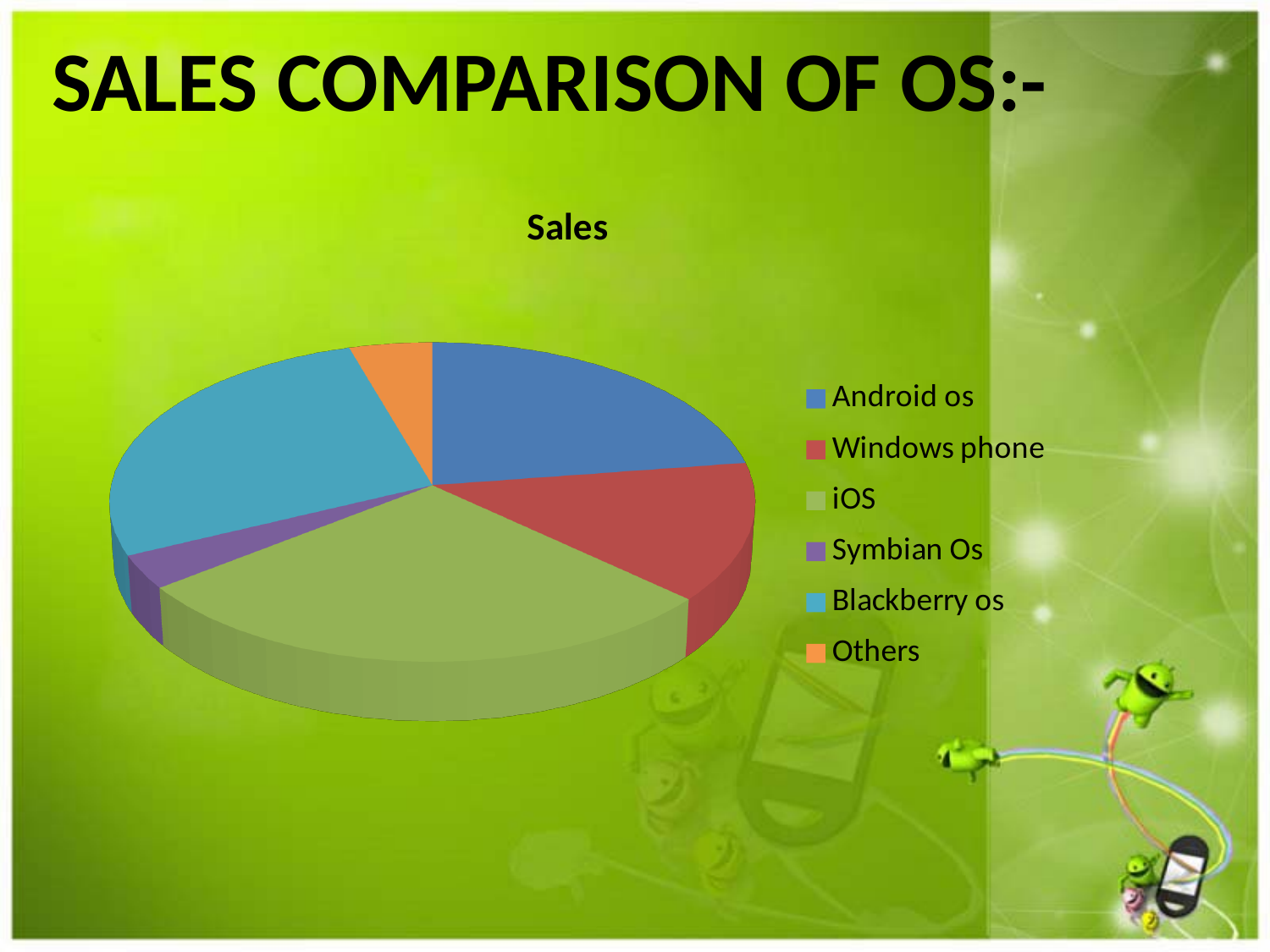
What is the title of the pie chart? Sales Which slice is larger, Blackberry os or Windows phone? Blackberry os How many entries does the legend of the pie chart list? 6 Which slice is larger, Android os or Windows phone? Android os Which slice is larger, Blackberry os or Symbian Os? Blackberry os How many categories (slices) does the pie chart have? 6 What kind of chart is shown on the slide? pie chart Which colour represents Windows phone in the pie chart? red